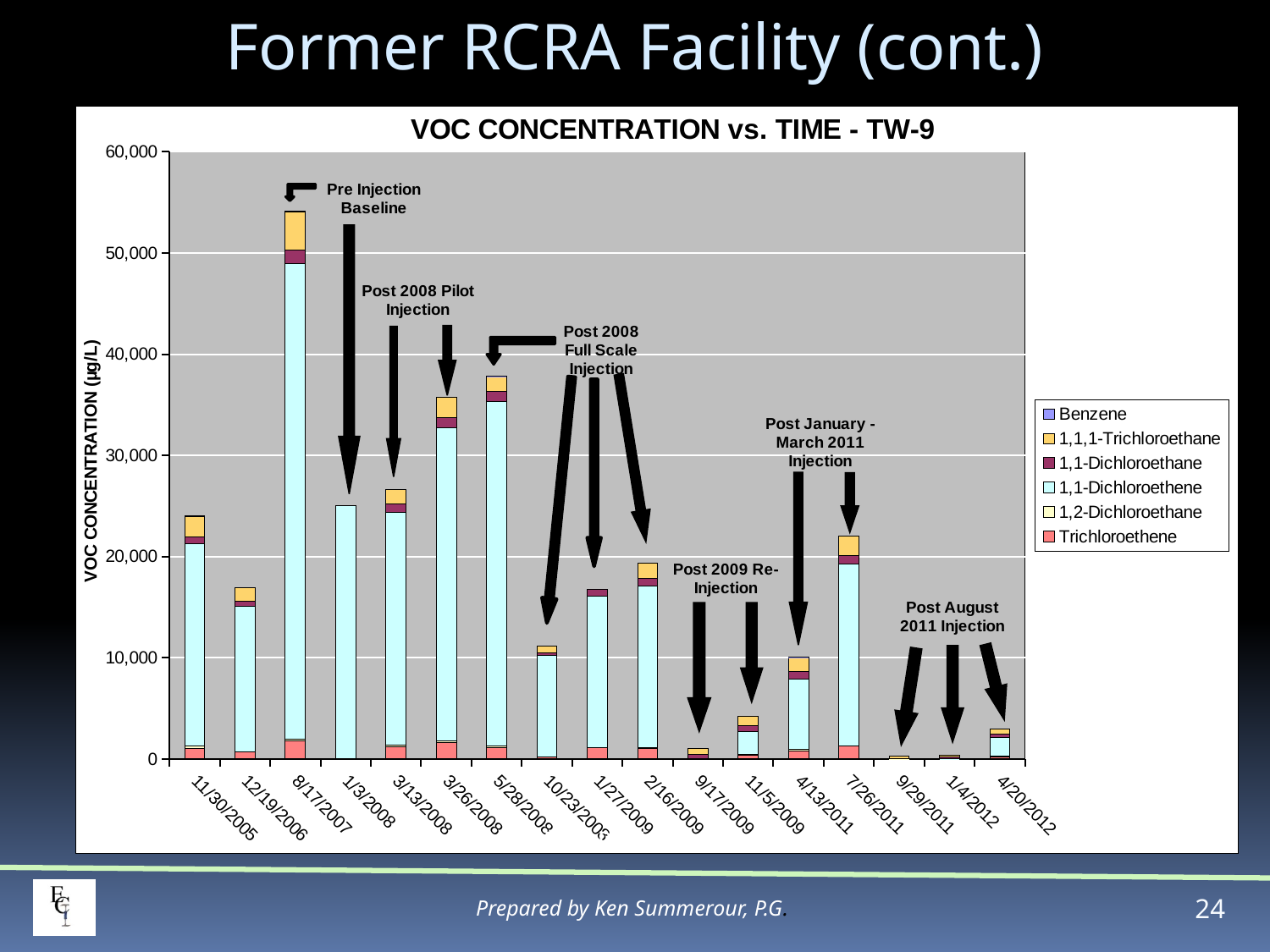
How many series does the legend of the VOC CONCENTRATION vs. TIME - TW-9 chart list? 6 What is the title of the chart? VOC CONCENTRATION vs. TIME - TW-9 What kind of chart is shown on the slide? Stacked bar chart Which sampling date has the highest total VOC concentration? 8/17/2007 What is the label on the y axis of the chart? VOC CONCENTRATION (µg/L) Is the total VOC concentration for 8/17/2007 greater or less than 50,000? greater How many sampling dates are shown along the x axis of the chart? 17 Which has the larger total VOC concentration, 4/13/2011 or 7/26/2011? 7/26/2011 Is the total VOC concentration for 4/20/2012 greater or less than 10,000? less Is the total VOC concentration for 5/28/2008 greater or less than 40,000? less Which has the larger total VOC concentration, 3/13/2008 or 3/26/2008? 3/26/2008